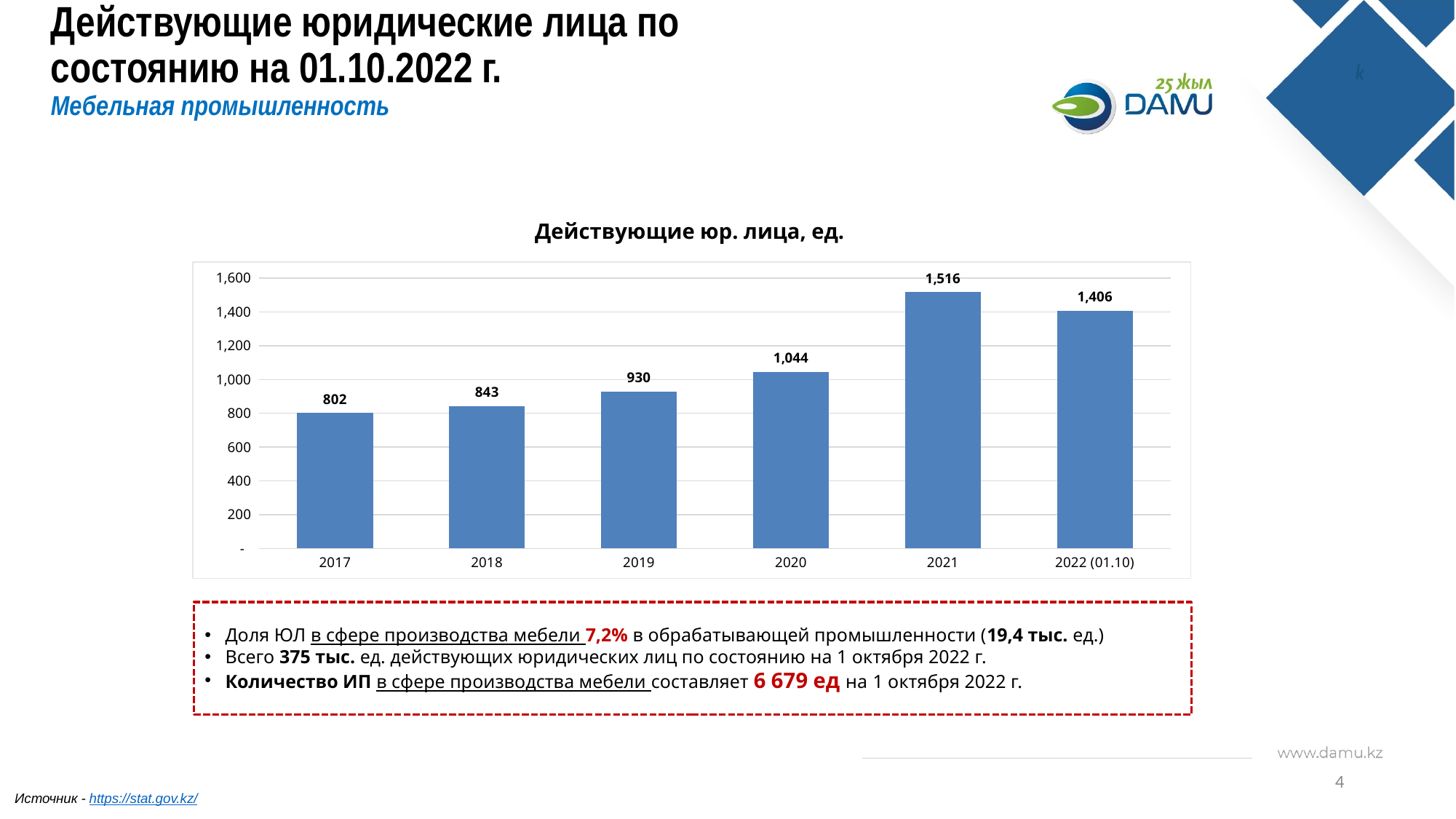
What is the difference between the values for 2019 and 2018? 87 Which year has the lowest value? 2017 Which year has the highest value? 2021 How many years are shown on the x axis? 6 What is the value for 2022 (01.10)? 1,406 What is the value for 2017? 802 What kind of chart is shown on the slide? bar chart What is the value for 2020? 1,044 What is the title of the chart? Действующие юр. лица, ед. What is the difference between the values for 2021 and 2022 (01.10)? 110 Is the value for 2021 greater or less than 1,400? greater Which is larger, the value for 2020 or the value for 2019? 2020